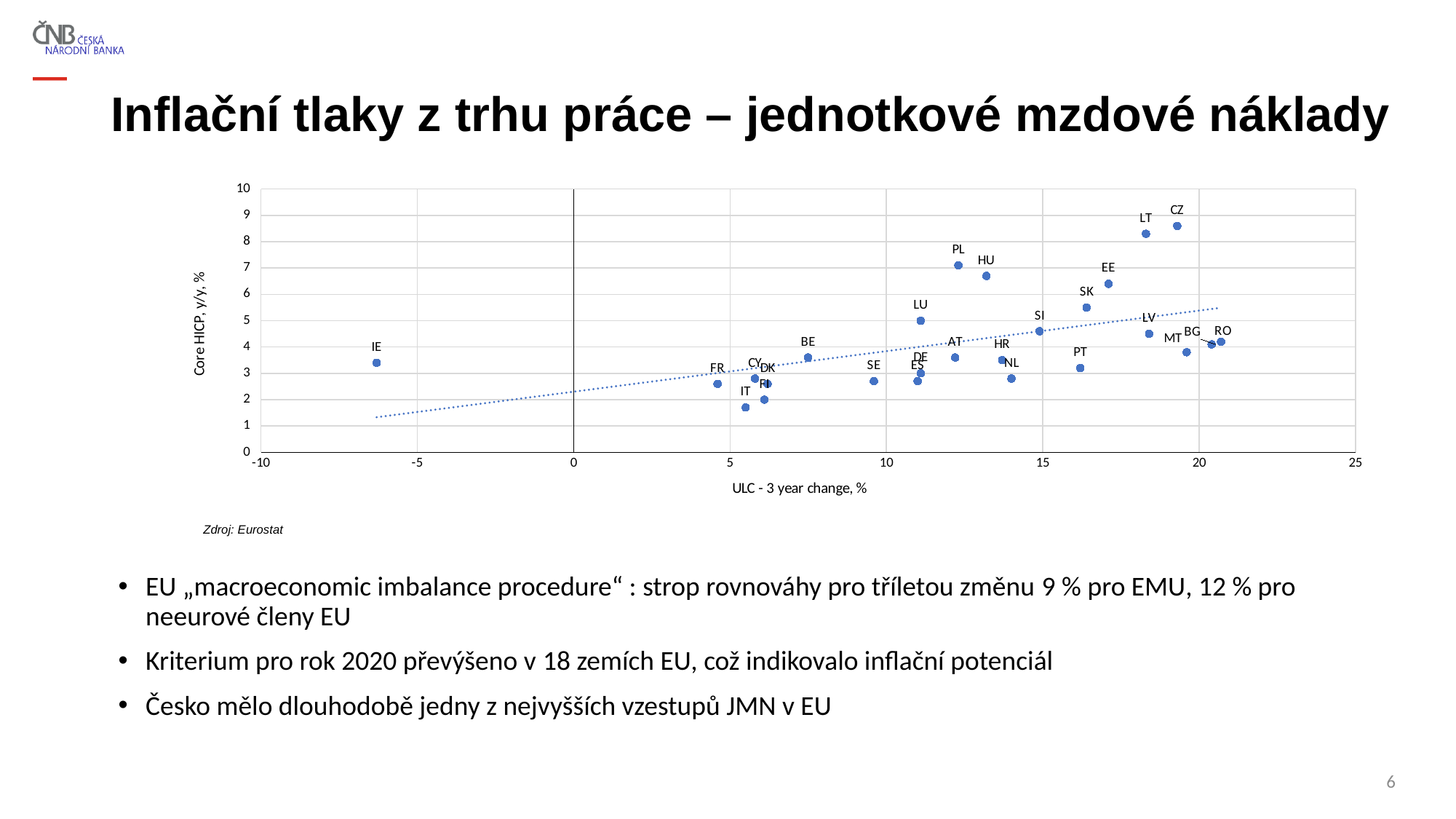
What kind of chart is shown on the slide? Scatter chart Is the ULC 3-year change for IE greater or less than 0? less Does the dotted trend line on the chart rise or fall as ULC 3-year change increases? Rises Is the core HICP value for IT greater or less than 2? less Which country has the lowest ULC 3-year change on the chart? IE What is the label of the horizontal axis of the chart? ULC - 3 year change, % Which country has a higher core HICP value, PL or NL? PL Which country has the lowest core HICP value on the chart? IT What is the label of the vertical axis of the chart? Core HICP, y/y, % How many country points are plotted on the chart? 26 Is the core HICP value for CZ greater or less than 8? greater Which country has the highest core HICP value on the chart? CZ